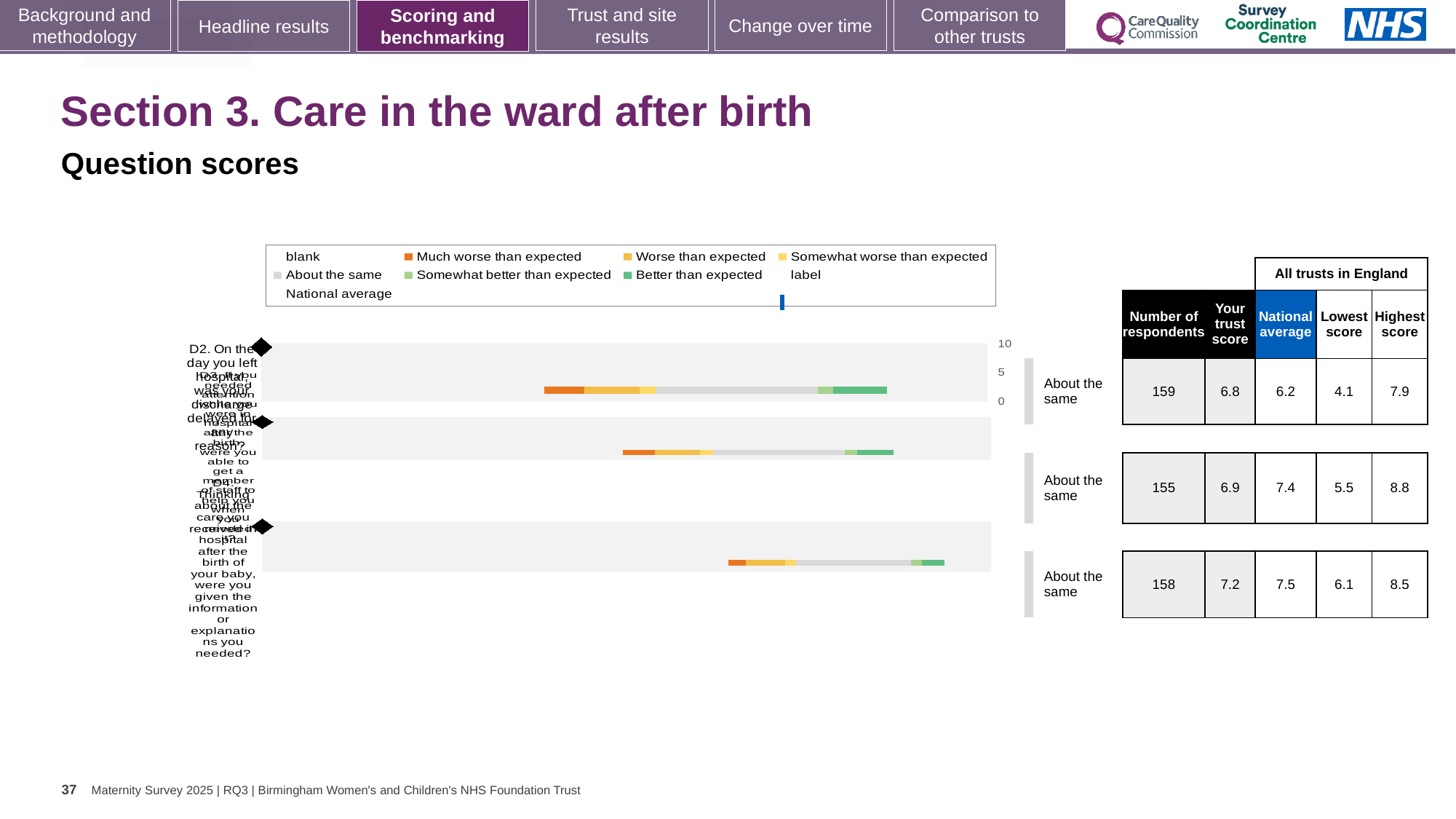
What is 'Your trust score' for the first row (D2, discharge delayed)? 6.8 What is the highest score for the third row? 8.5 Which row has the highest 'Your trust score'? the third row (7.2) What is the number of respondents for the first row (D2, discharge delayed)? 159 For the first row (D2), which is larger: 'Your trust score' or the 'National average'? Your trust score What kind of chart is shown on the slide? bar chart How many question rows (bars) are plotted in the chart? 3 What benchmark category is shown for the second row? About the same For the first row (D2), what is the difference between the highest score and the lowest score? 3.8 Which row has the lowest 'Lowest score' value? the first row (4.1) In the chart legend, what colour represents 'Much worse than expected'? orange What is the national average for the second row? 7.4